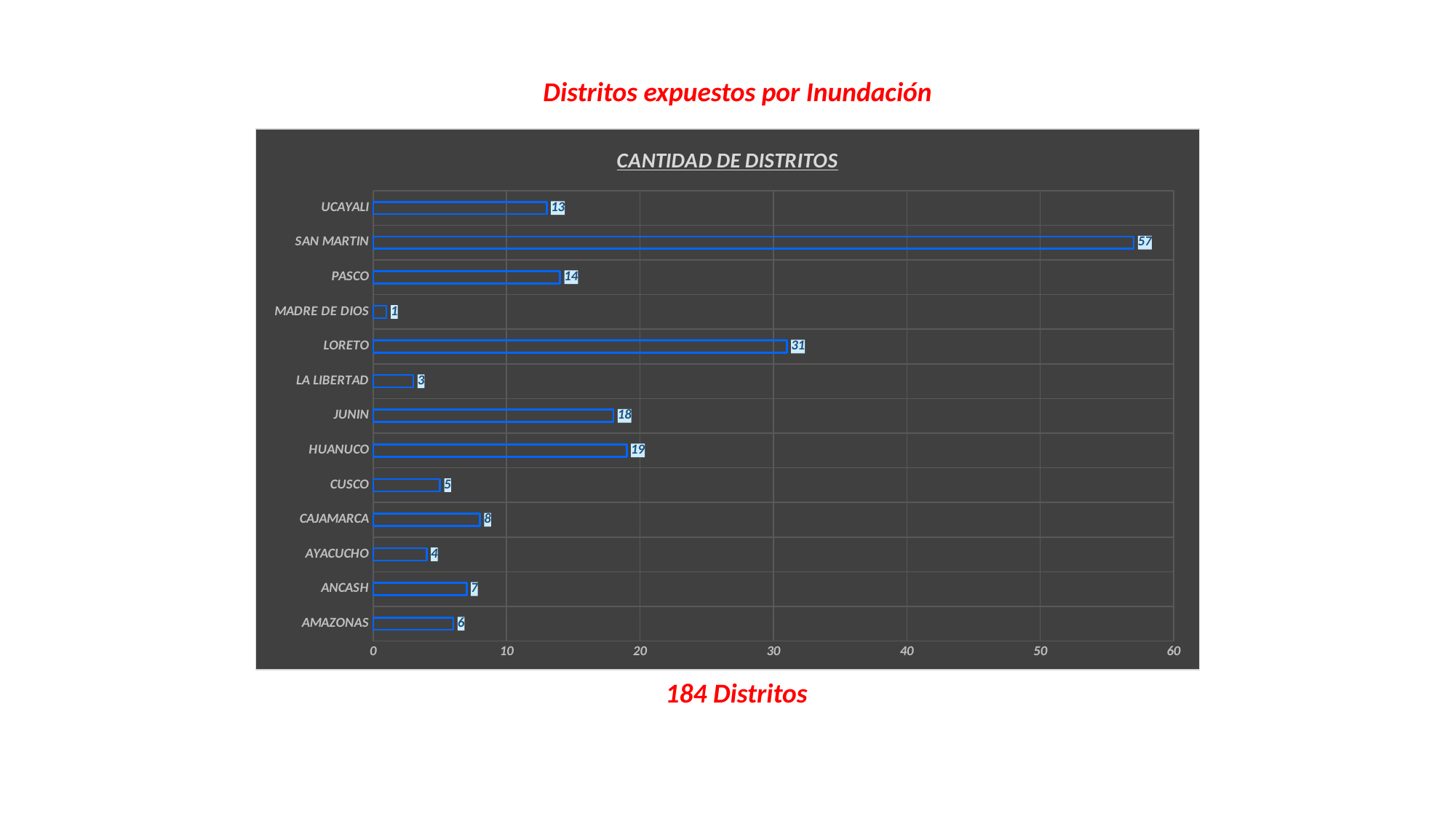
What is the title of the chart? CANTIDAD DE DISTRITOS Which category has the lowest value? MADRE DE DIOS What is the difference between the values for UCAYALI and CUSCO? 8 Which is larger, the value for JUNIN or the value for PASCO? JUNIN What is the value for SAN MARTIN? 57 How many categories are shown in the chart? 13 What is the value for HUANUCO? 19 What is the difference between the values for SAN MARTIN and LORETO? 26 Which category has the highest value? SAN MARTIN What kind of chart is shown on the slide? Bar chart What is the value for LORETO? 31 What is the value for MADRE DE DIOS? 1